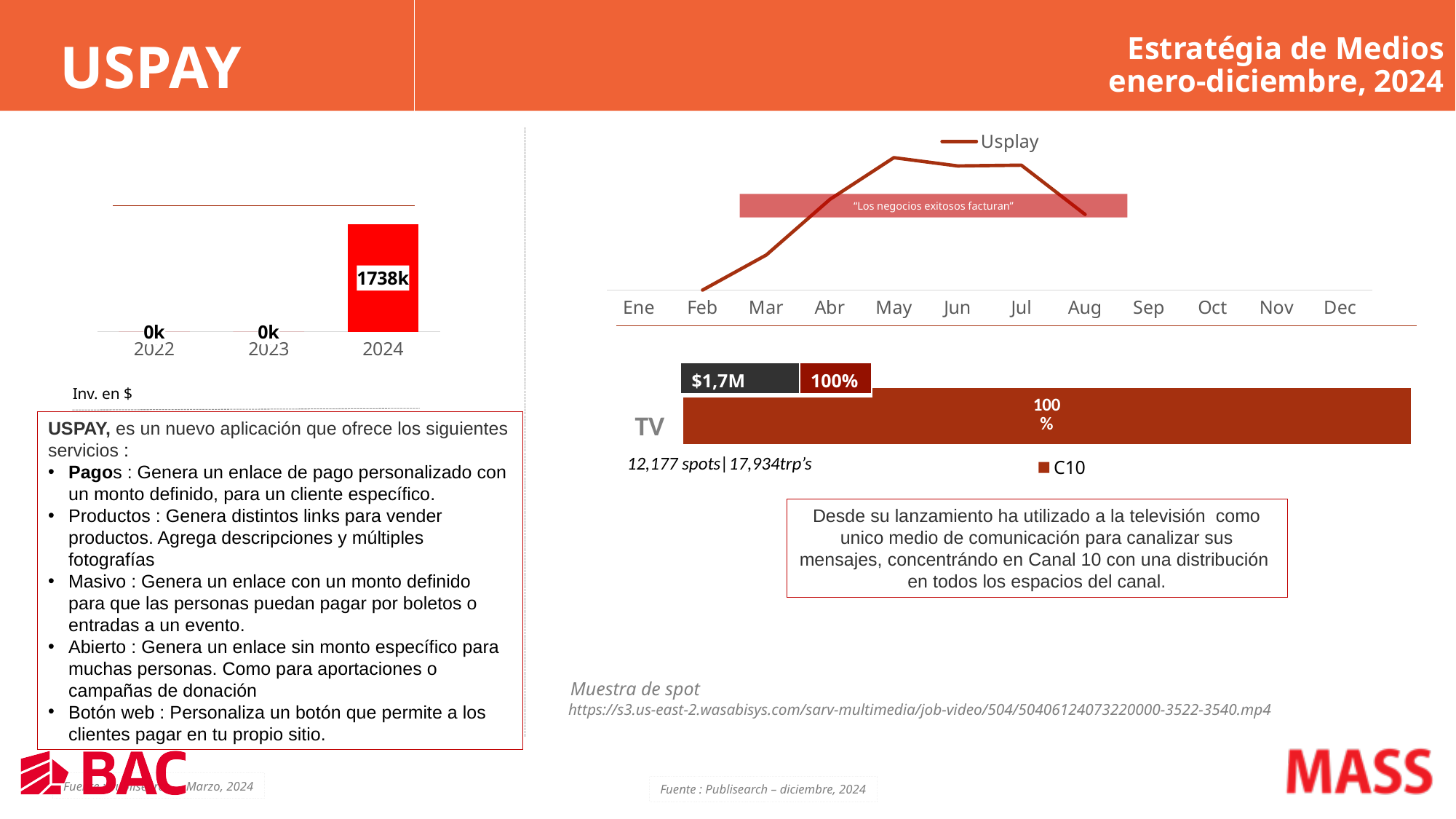
On the bar chart on the left (Inv. en $), what is the value for 2024? 1738k On the bar chart on the left (Inv. en $), what is the difference between the 2024 value and the 2023 value? 1738k On the bar chart on the left (Inv. en $), which year has the highest value? 2024 On the bar chart on the left (Inv. en $), what is the value for 2022? 0k What kind of chart is the chart on the left showing Inv. en $? bar chart On the TV bar chart on the right, what percentage is shown for C10? 100% What kind of chart is the Usplay chart at the top right? line chart On the bar chart on the left (Inv. en $), how many years are shown on the x axis? 3 On the Usplay line chart at the top right, which series does the legend list? Usplay On the Usplay line chart at the top right, how many months are labelled on the x axis? 12 On the bar chart on the left (Inv. en $), what is the value for 2023? 0k On the TV bar chart on the right, how many series does the legend list? 1